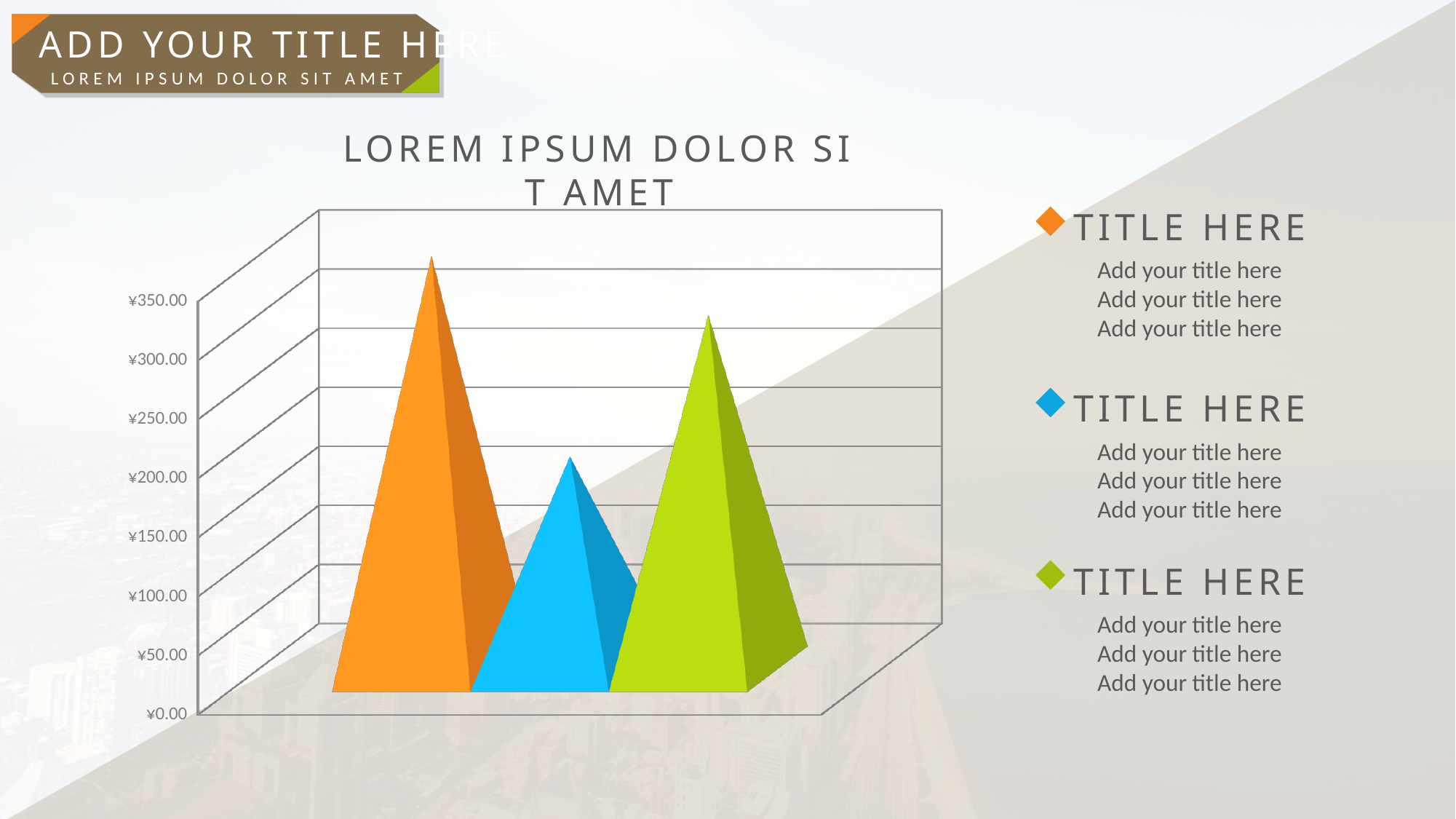
Is the value of the blue bar greater or less than ¥100.00? greater What is the title of the chart? LOREM IPSUM DOLOR SIT AMET Which bar is the tallest in the chart? the orange bar What is the highest value labelled on the chart's vertical axis? ¥350.00 Which bar is the shortest in the chart? the blue bar What kind of chart is shown on the slide? bar chart Is the value of the blue bar greater or less than ¥300.00? less Which is larger, the orange bar or the blue bar? the orange bar How many bars are plotted in the chart? 3 Is the value of the green bar greater or less than ¥200.00? greater Which is larger, the green bar or the blue bar? the green bar